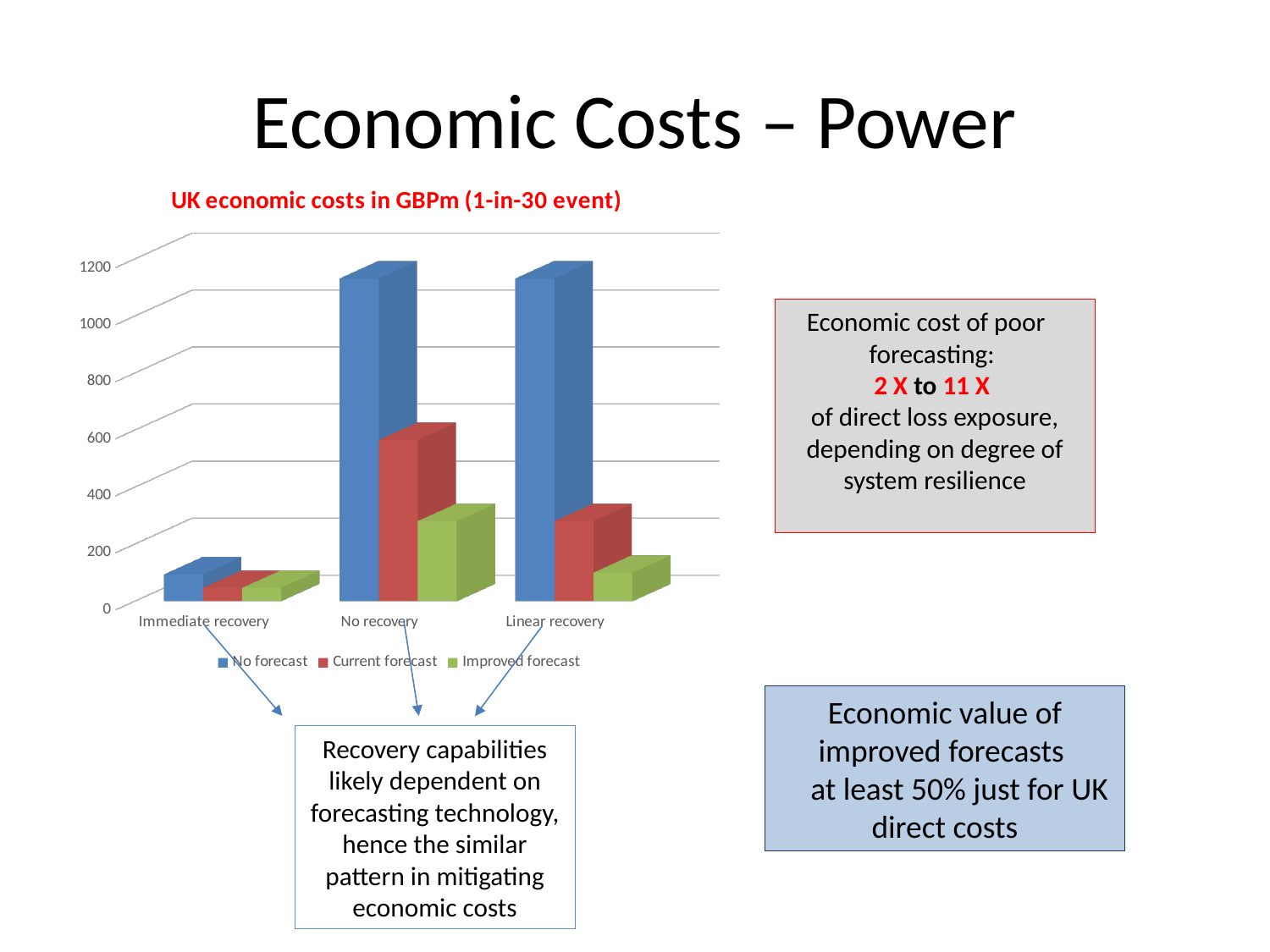
Within the No recovery category, which series has the lowest value? Improved forecast How many series does the chart legend list? 3 Is the value for Improved forecast under Linear recovery greater or less than 200? less What is the title of the chart? UK economic costs in GBPm (1-in-30 event) Is the value for No forecast under No recovery greater or less than 1000? greater How many recovery categories are shown on the x axis? 3 Within the No recovery category, which series has the highest value? No forecast Which series is shown in green in the chart? Improved forecast What kind of chart is shown on the slide? Bar chart Which is larger: the Current forecast value for No recovery or for Linear recovery? No recovery Is the value for No forecast under Immediate recovery greater or less than 200? less